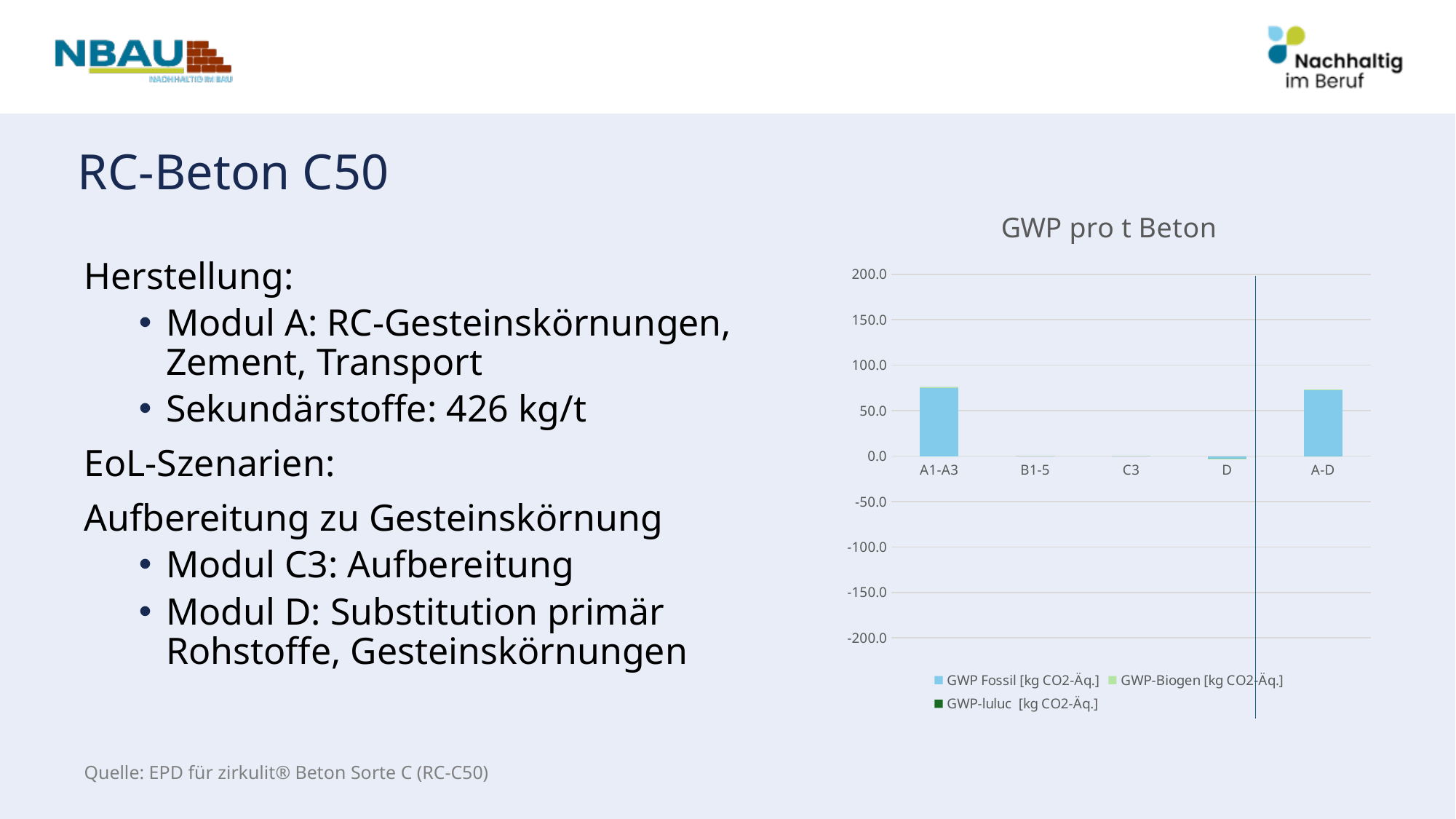
What is the title of the chart? GWP pro t Beton What kind of chart is shown on the slide? bar chart How many categories are shown on the x axis of the chart? 5 Is the GWP Fossil value for A-D greater or less than 100.0? less How many series does the chart legend list? 3 Is the GWP Fossil value for A1-A3 greater or less than 50.0? greater Which series in the legend is shown in light blue? GWP Fossil [kg CO2-Äq.] Is the GWP Fossil value for A-D greater or less than 50.0? greater What is the lowest value shown on the y axis of the chart? -200.0 Which has the larger GWP Fossil value, A1-A3 or B1-5? A1-A3 Which has the larger GWP Fossil value, A-D or C3? A-D